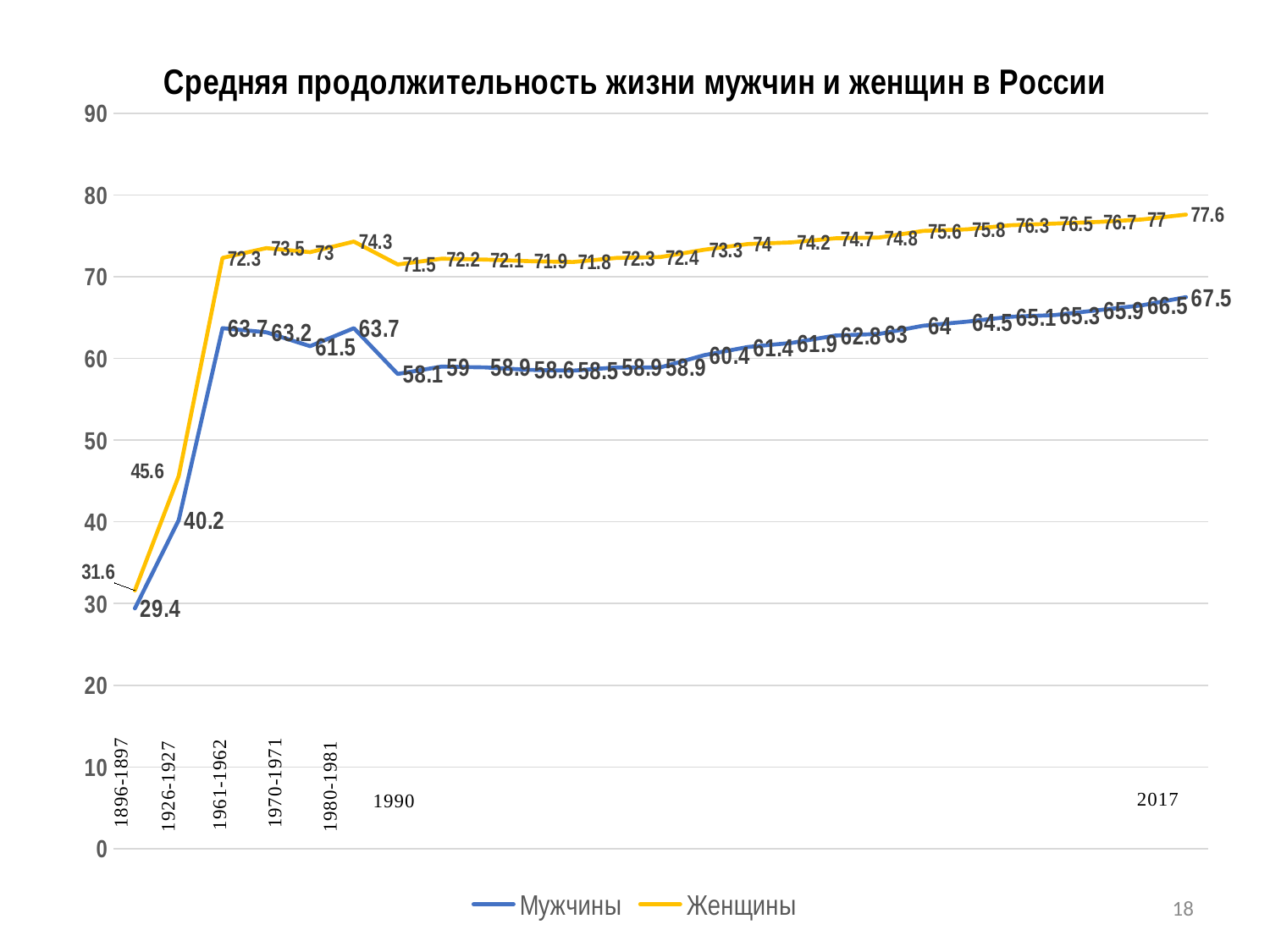
In which period is the Мужчины value lowest? 1896-1897 What is the value for Мужчины in 1896-1897? 29.4 What is the difference between the Женщины and Мужчины values in 1896-1897? 2.2 How many series does the legend list? 2 What is the value for Мужчины in 1980-1981? 61.5 What is the difference between the Женщины and Мужчины values in 2017? 10.1 What is the value for Мужчины in 2017? 67.5 What is the value for Женщины in 2017? 77.6 Which series has the higher value in 1970-1971, Мужчины or Женщины? Женщины What is the title of the chart? Средняя продолжительность жизни мужчин и женщин в России What is the value for Женщины in 1926-1927? 45.6 What type of chart is shown on the slide? line chart